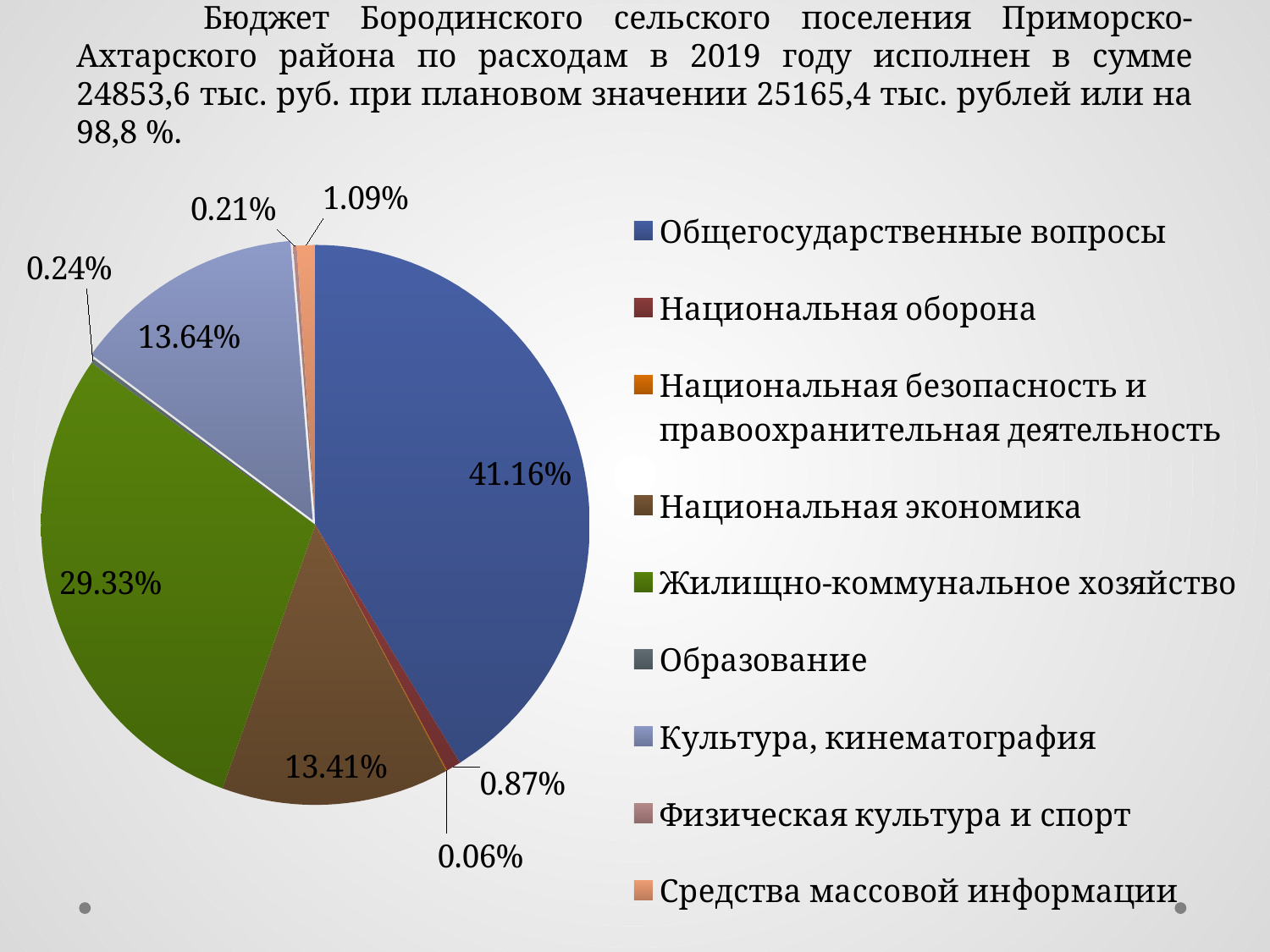
Which category has the largest slice of the pie? Общегосударственные вопросы What is the value shown for Национальная экономика? 13.41% Which category has the smallest slice of the pie? Национальная безопасность и правоохранительная деятельность What is the difference between the shares of Общегосударственные вопросы and Жилищно-коммунальное хозяйство? 11.83% What colour is the slice for Жилищно-коммунальное хозяйство? green How many categories does the legend of the pie chart list? 9 What is the value shown for Жилищно-коммунальное хозяйство? 29.33% Which is larger, the share of Национальная оборона or the share of Образование? Национальная оборона What share of the pie does Общегосударственные вопросы take? 41.16% What is the value shown for Культура, кинематография? 13.64% What kind of chart is shown on the slide? pie chart What is the value shown for Средства массовой информации? 1.09%